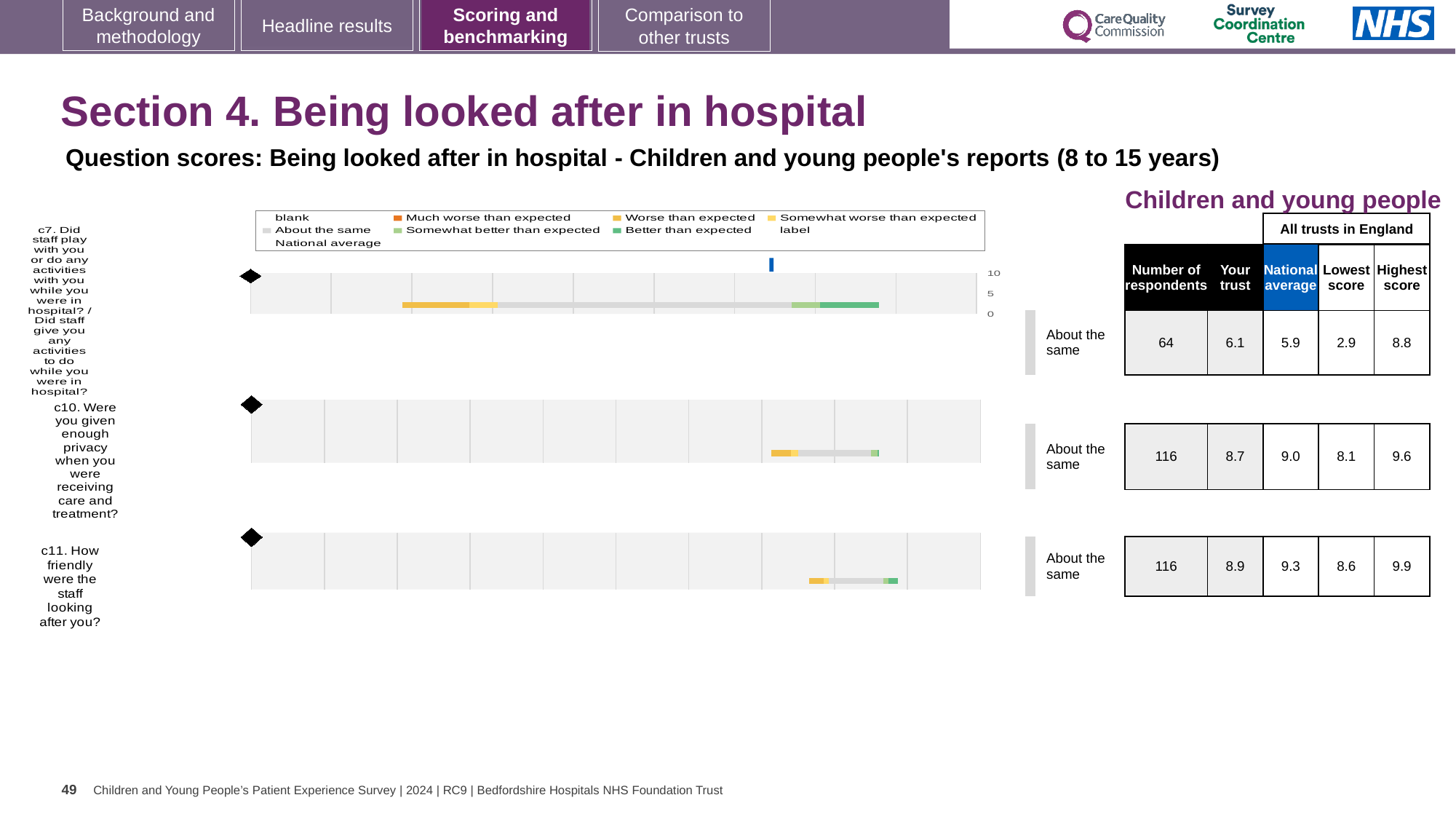
For the c7 chart, what is the lowest score among all trusts in England? 2.9 Which question has the lowest 'Your trust' score? c7. Did staff play with you or do any activities with you while you were in hospital? What benchmark category is shown for the c10 chart? About the same For the c7 chart (did staff play with you or do any activities), how many respondents are there? 64 For the c10 chart, how much higher is the national average than the 'Your trust' score? 0.3 For the c11 chart (how friendly were the staff), what is the national average score? 9.3 Which question has the highest 'Your trust' score? c11. How friendly were the staff looking after you? For the c7 chart, which is larger: the 'Your trust' score or the national average? Your trust What kind of chart is used to show the question scores on this slide? bar chart How many questions (charts) are shown on the slide? 3 For the c10 chart (privacy when receiving care and treatment), what is the 'Your trust' score? 8.7 For the c11 chart, what is the difference between the highest score and the lowest score among all trusts in England? 1.3